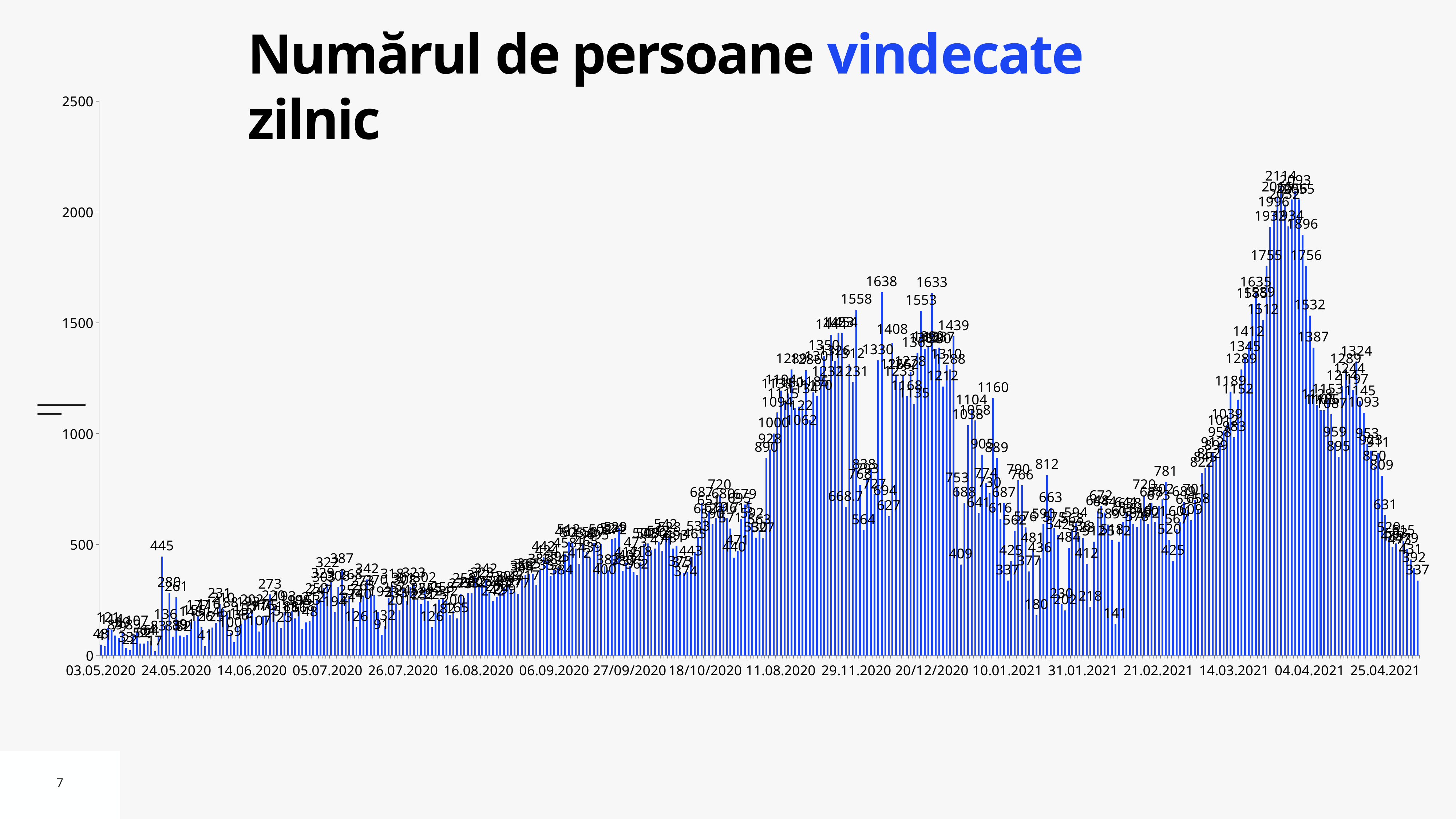
What is the difference between the peak value 2114 and the peak value 1638? 476 What is the value of the tallest bar near 29.11.2020? 1638 Is the tallest bar on the chart greater or less than 2000? greater What kind of chart is shown on the slide? bar chart What is the title of the chart? Numărul de persoane vindecate zilnic Is the spike near 24.05.2020 greater or less than 500? less What is the first date label on the x axis? 03.05.2020 Which is larger, the peak value 2114 in April 2021 or the peak value 1638 in November 2020? 2114 What is the highest value labelled on the chart? 2114 What is the value of the isolated spike near 24.05.2020? 445 What is the highest tick value on the y axis? 2500 What is the value of the last bar on the right of the chart? 337